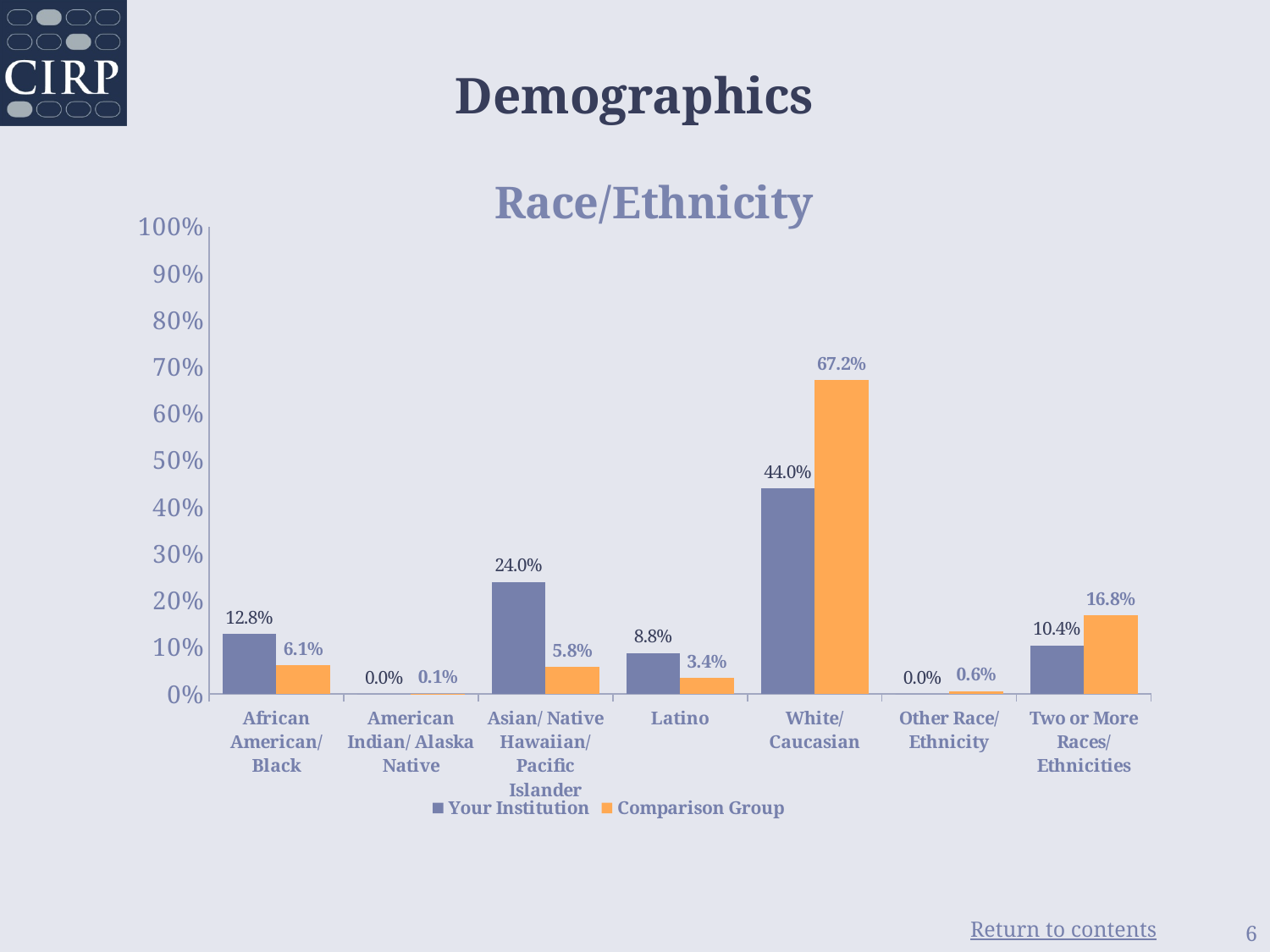
What is the value for Your Institution in the White/Caucasian category? 44.0% What kind of chart is shown on the slide? Bar chart Is the Comparison Group value for White/Caucasian greater or less than 60%? greater What is the value for the Comparison Group in the Two or More Races/Ethnicities category? 16.8% What is the value for Your Institution in the Asian/Native Hawaiian/Pacific Islander category? 24.0% What is the difference between the Comparison Group and Your Institution values for White/Caucasian? 23.2% How many series does the legend list? 2 How many race/ethnicity categories are shown on the x axis? 7 Which is larger for Latino: Your Institution or the Comparison Group? Your Institution Which category has the lowest value for the Comparison Group? American Indian/Alaska Native What is the difference between Your Institution and the Comparison Group values for African American/Black? 6.7% Which category has the highest value for the Comparison Group? White/Caucasian